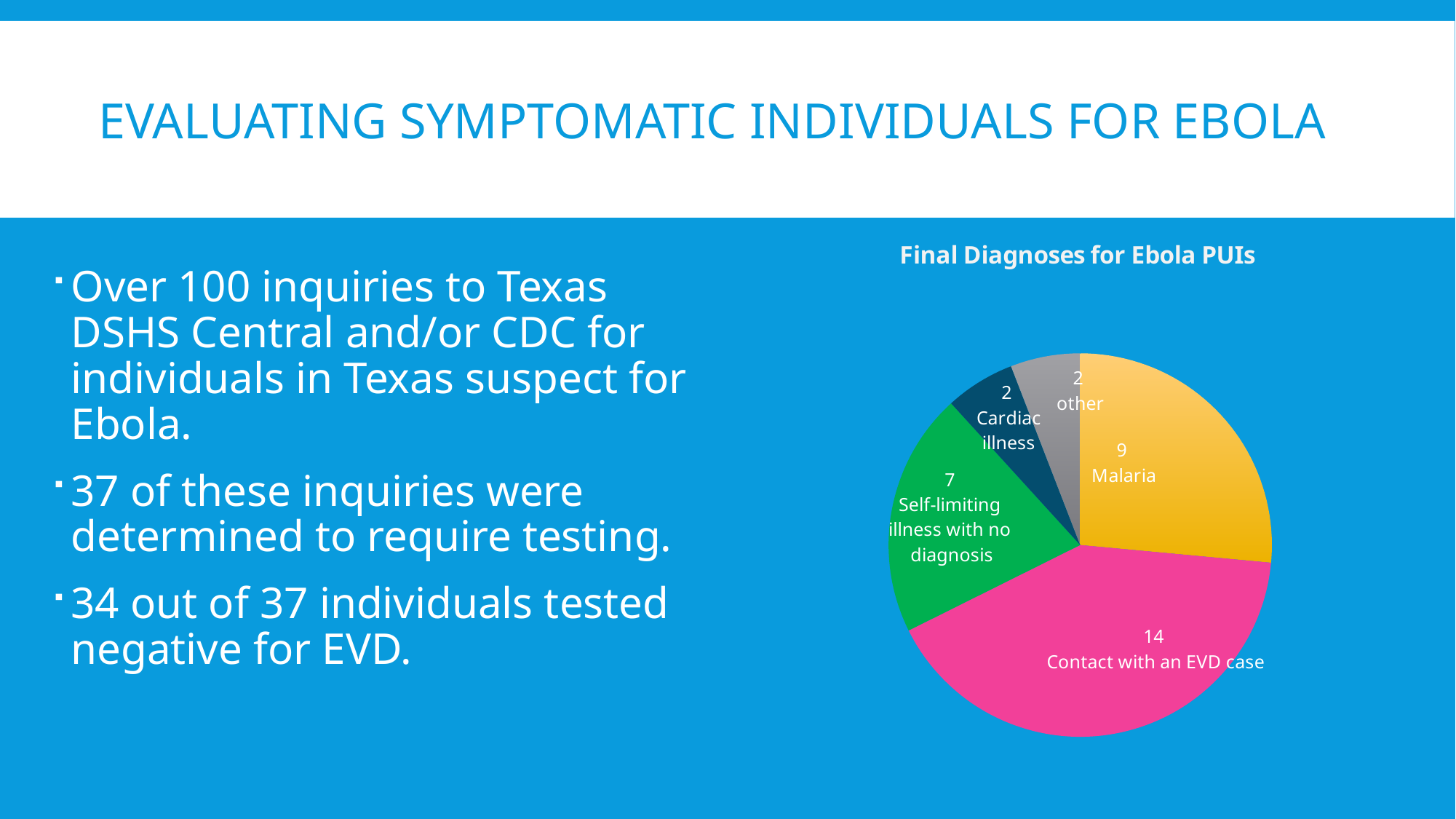
What is the total of all the slices in the pie chart? 34 What is the value for Contact with an EVD case? 14 What is the value for Cardiac illness? 2 What is the value for Self-limiting illness with no diagnosis? 7 Which diagnosis category has the largest slice of the pie? Contact with an EVD case What is the difference between the Contact with an EVD case value and the Malaria value? 5 Which is larger, Malaria or Self-limiting illness with no diagnosis? Malaria How many individuals had a final diagnosis of Malaria? 9 What colour is the Contact with an EVD case slice? Pink What type of chart is shown on the slide? Pie chart How many slices does the pie chart have? 5 What is the title of the chart? Final Diagnoses for Ebola PUIs